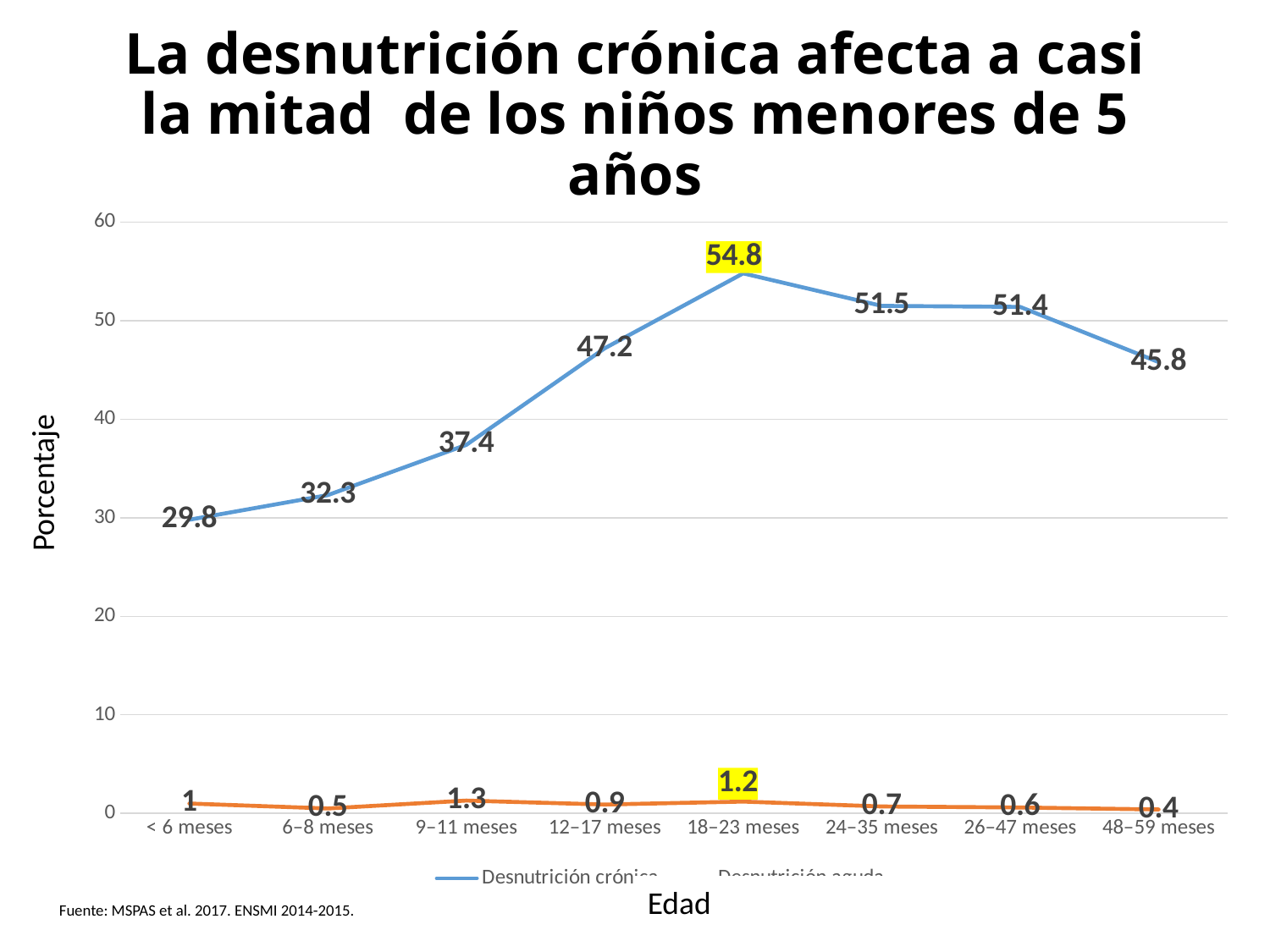
How many series does the legend list? 2 Which is larger, the Desnutrición crónica value for 12–17 meses or for 9–11 meses? 12–17 meses Which age group has the highest value for Desnutrición crónica? 18–23 meses What is the value of Desnutrición aguda for 9–11 meses? 1.3 Does the Desnutrición crónica line rise or fall from < 6 meses to 18–23 meses? rise How many age groups are shown on the x axis? 8 What type of chart is shown on the slide? line chart Which age group has the lowest value for Desnutrición aguda? 48–59 meses What is the label of the y axis? Porcentaje What is the value of Desnutrición crónica for 18–23 meses? 54.8 What is the difference between the Desnutrición crónica values for 18–23 meses and 48–59 meses? 9 What is the value of Desnutrición crónica for < 6 meses? 29.8